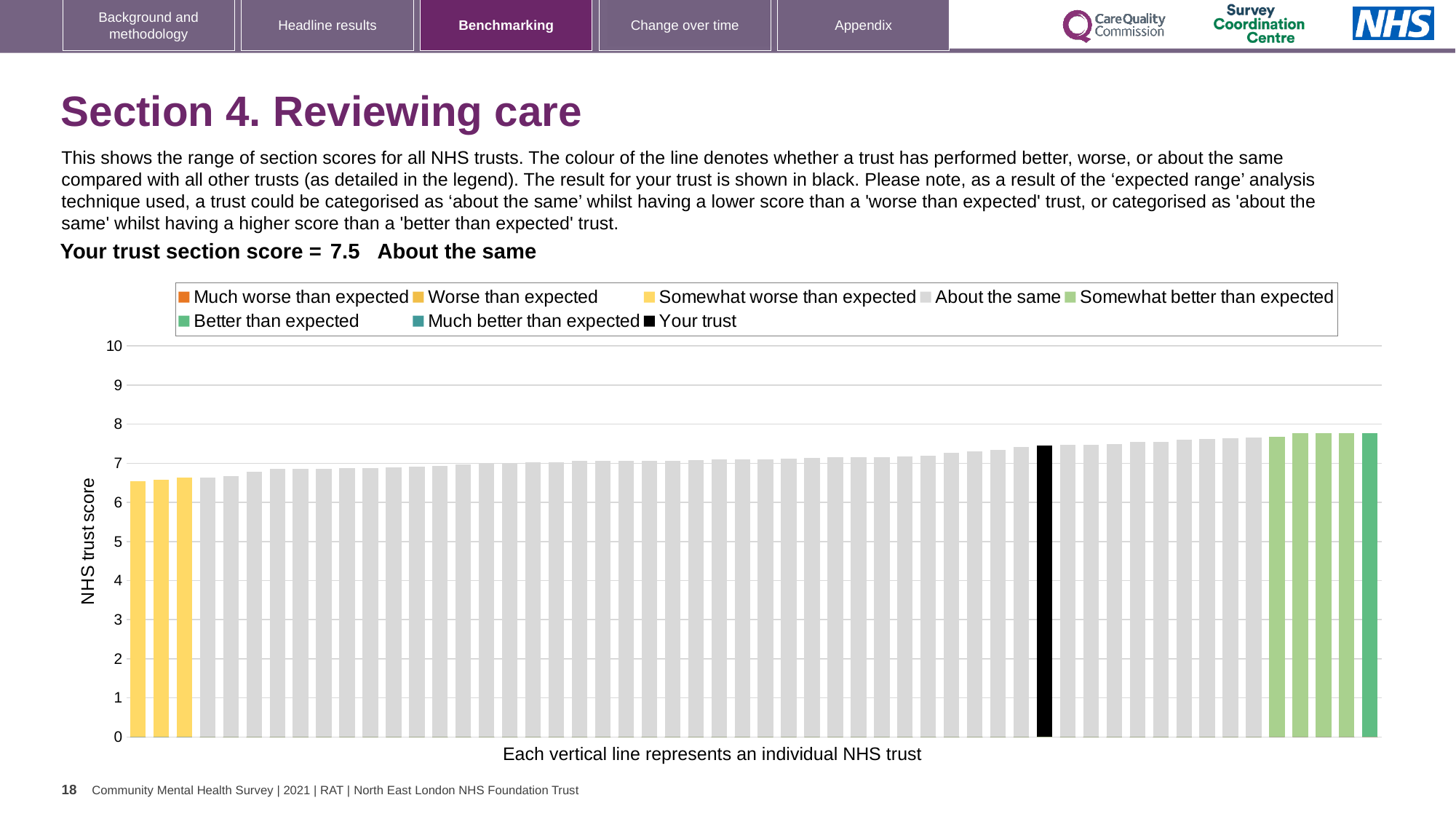
Is the value of the black 'Your trust' bar greater or less than 7? greater Which category is your trust placed in for this section? About the same Is the value of the rightmost bar greater or less than 8? less How many bars are coloured as 'Somewhat worse than expected' (yellow)? 3 How many entries does the chart legend list? 8 What is the section score for your trust? 7.5 What kind of chart is shown on the slide? Bar chart What colour is used for the 'Your trust' bar? Black Which is larger, the leftmost bar or the rightmost bar? The rightmost bar Do the bar values rise or fall from left to right along the x axis? Rise What is the label on the y axis? NHS trust score Is the value of the leftmost bar greater or less than 7? less